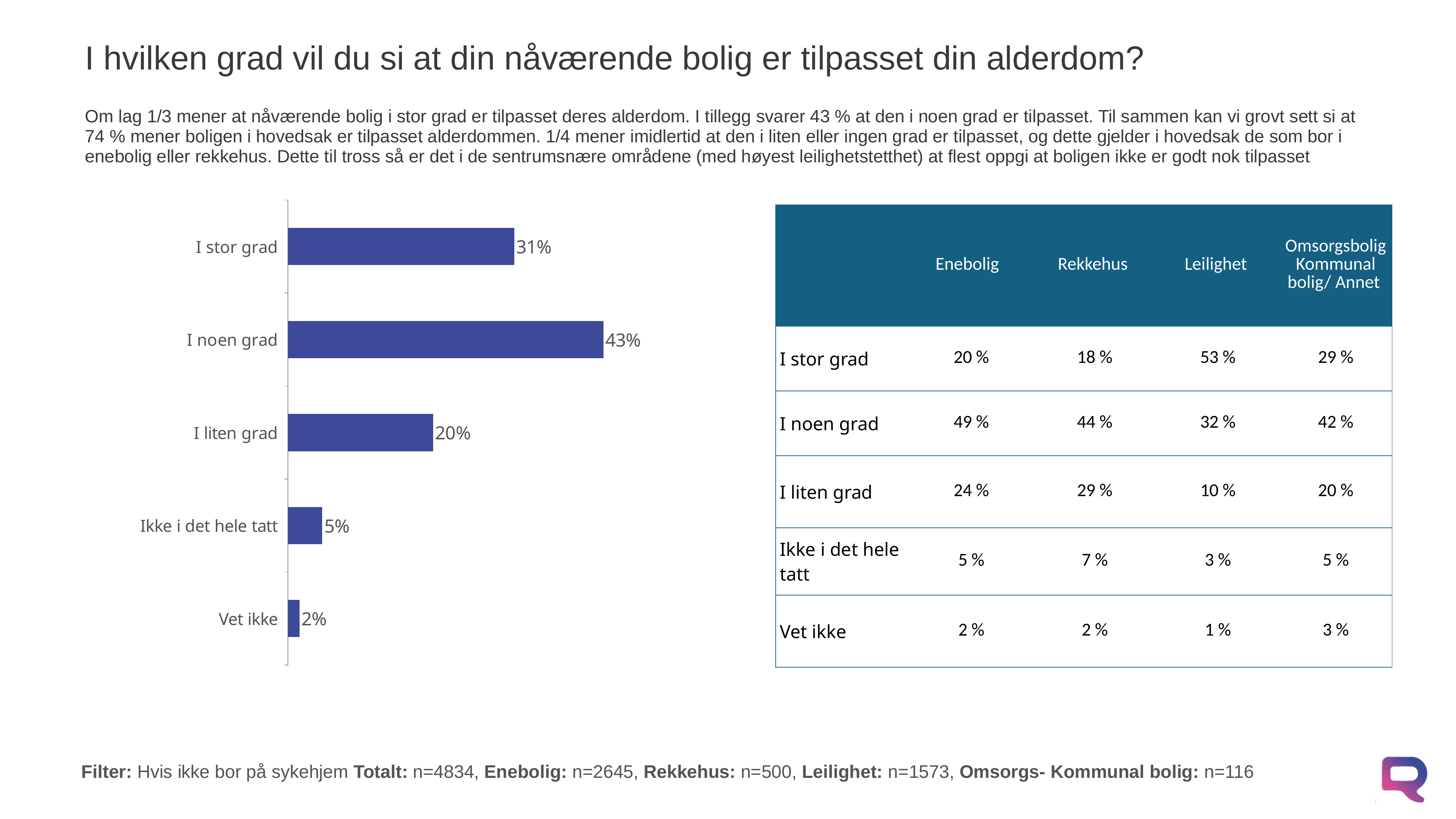
What is the value for "Vet ikke" in the bar chart? 2% What is the difference between the values for "I noen grad" and "I stor grad" in the bar chart? 12% What is the value for "Ikke i det hele tatt" in the bar chart? 5% What is the difference between the values for "I liten grad" and "Ikke i det hele tatt" in the bar chart? 15% What is the value for "I stor grad" in the bar chart? 31% What colour are the bars in the bar chart? Blue Which category has the highest value in the bar chart? I noen grad How many categories are shown in the bar chart? 5 What is the value for "I noen grad" in the bar chart? 43% Which is larger in the bar chart, the value for "I stor grad" or the value for "I liten grad"? I stor grad What kind of chart is shown on the left of the slide? Bar chart Which category has the lowest value in the bar chart? Vet ikke